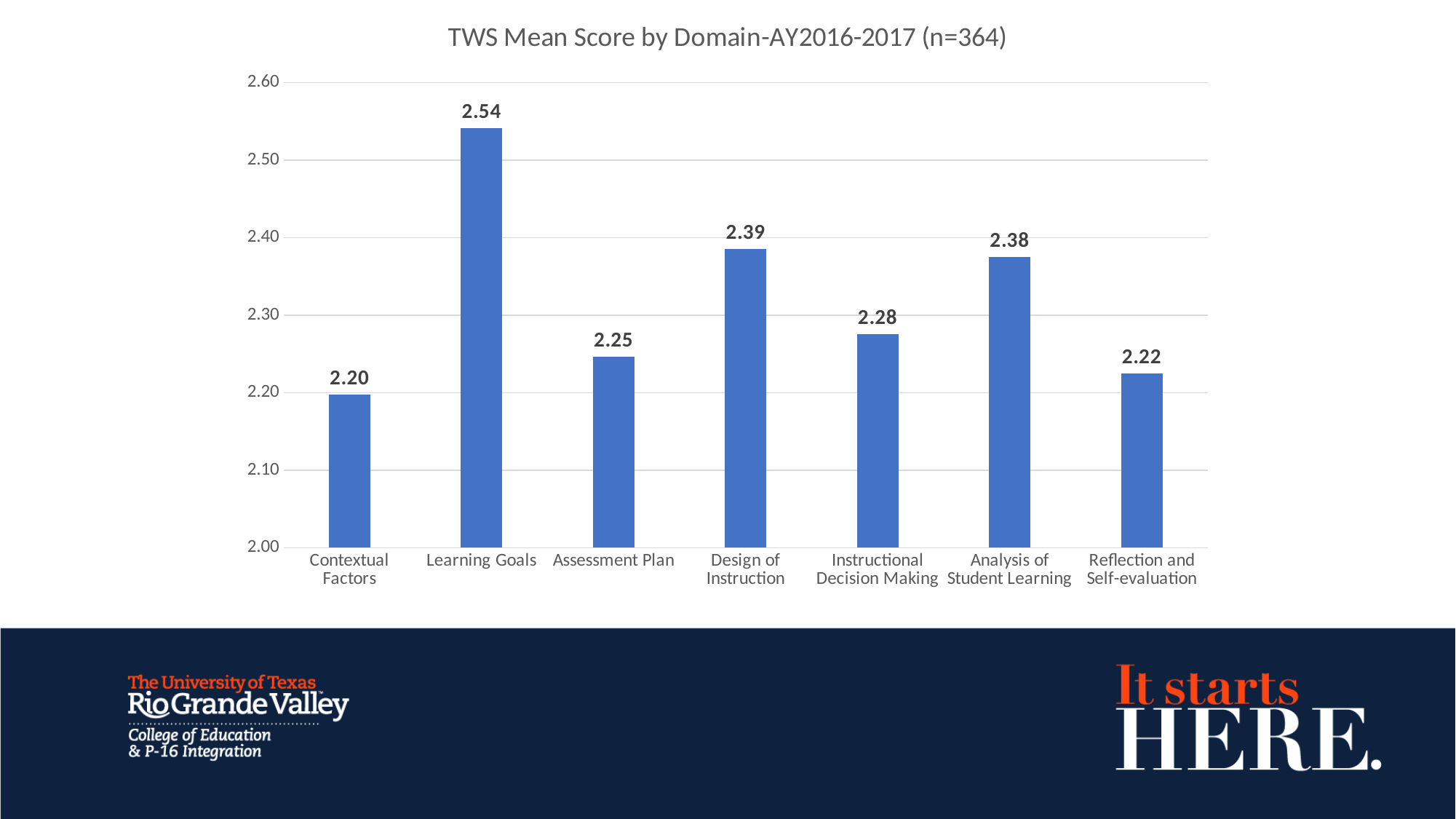
What is the mean score for Instructional Decision Making? 2.28 What is the mean score for Reflection and Self-evaluation? 2.22 What is the mean score for Assessment Plan? 2.25 What is the difference between the mean scores for Design of Instruction and Assessment Plan? 0.14 What is the mean score for Learning Goals? 2.54 What is the title of the chart? TWS Mean Score by Domain-AY2016-2017 (n=364) What is the difference between the mean scores for Learning Goals and Contextual Factors? 0.34 Which has a higher mean score, Analysis of Student Learning or Instructional Decision Making? Analysis of Student Learning How many domains are plotted in the chart? 7 Which domain has the highest mean score? Learning Goals What type of chart is shown on the slide? Bar chart Is the value for Learning Goals greater or less than 2.50? greater